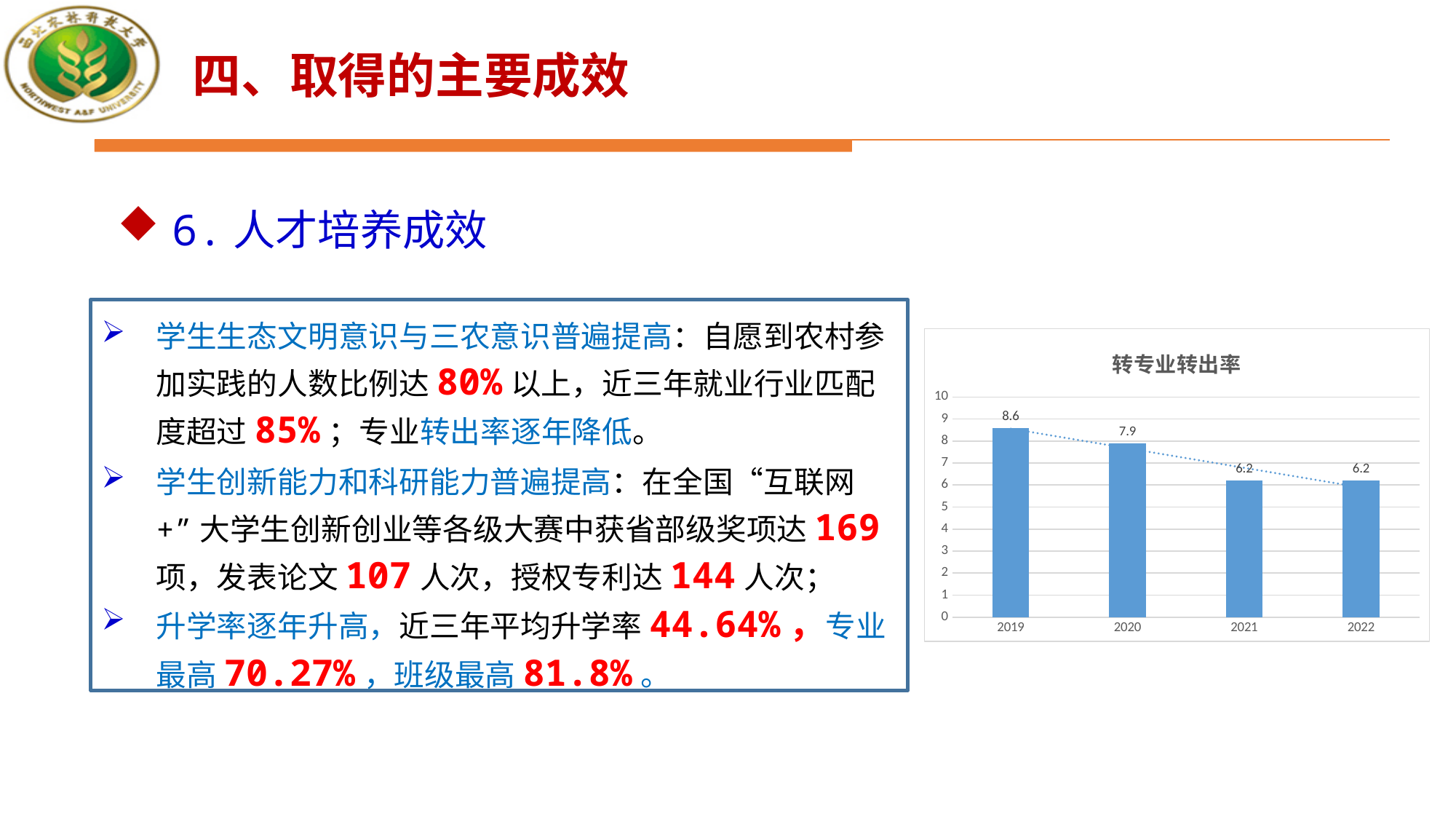
How many years are shown on the x axis of the 转专业转出率 chart? 4 Do the values in the 转专业转出率 chart rise or fall from 2019 to 2022? fall What is the value for 2022 in the 转专业转出率 chart? 6.2 What is the title of the chart on the slide? 转专业转出率 What is the value for 2020 in the 转专业转出率 chart? 7.9 What is the value for 2019 in the 转专业转出率 chart? 8.6 What kind of chart is the 转专业转出率 chart? bar chart What is the difference between the 2019 and 2022 values in the 转专业转出率 chart? 2.4 Is the value for 2020 in the 转专业转出率 chart greater or less than 7? greater Which year has the highest value in the 转专业转出率 chart? 2019 What is the difference between the 2019 and 2020 values in the 转专业转出率 chart? 0.7 Which is larger in the 转专业转出率 chart, the value for 2020 or the value for 2021? 2020